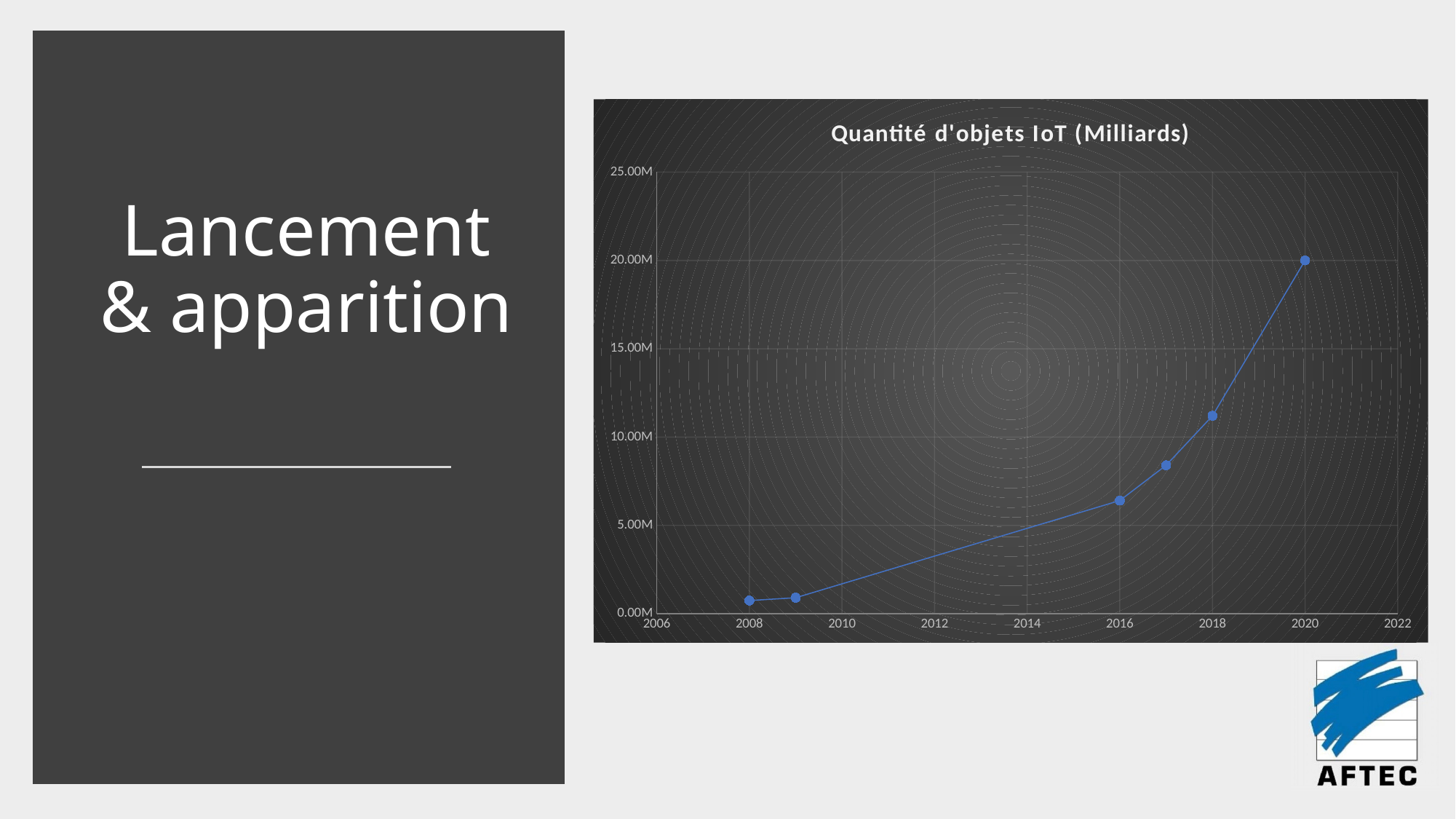
Which year has the highest value on the chart? 2020 Is the value for 2009 greater or less than 5.00M? less Which year has the lowest value on the chart? 2008 Is the value for 2016 greater or less than 5.00M? greater Is the value for 2018 greater or less than 10.00M? greater How many data points are plotted on the chart? 6 Do the values rise or fall from 2008 to 2020? rise Which is larger, the value for 2018 or the value for 2016? 2018 What is the title of the chart? Quantité d'objets IoT (Milliards) What kind of chart is shown on the slide? line chart